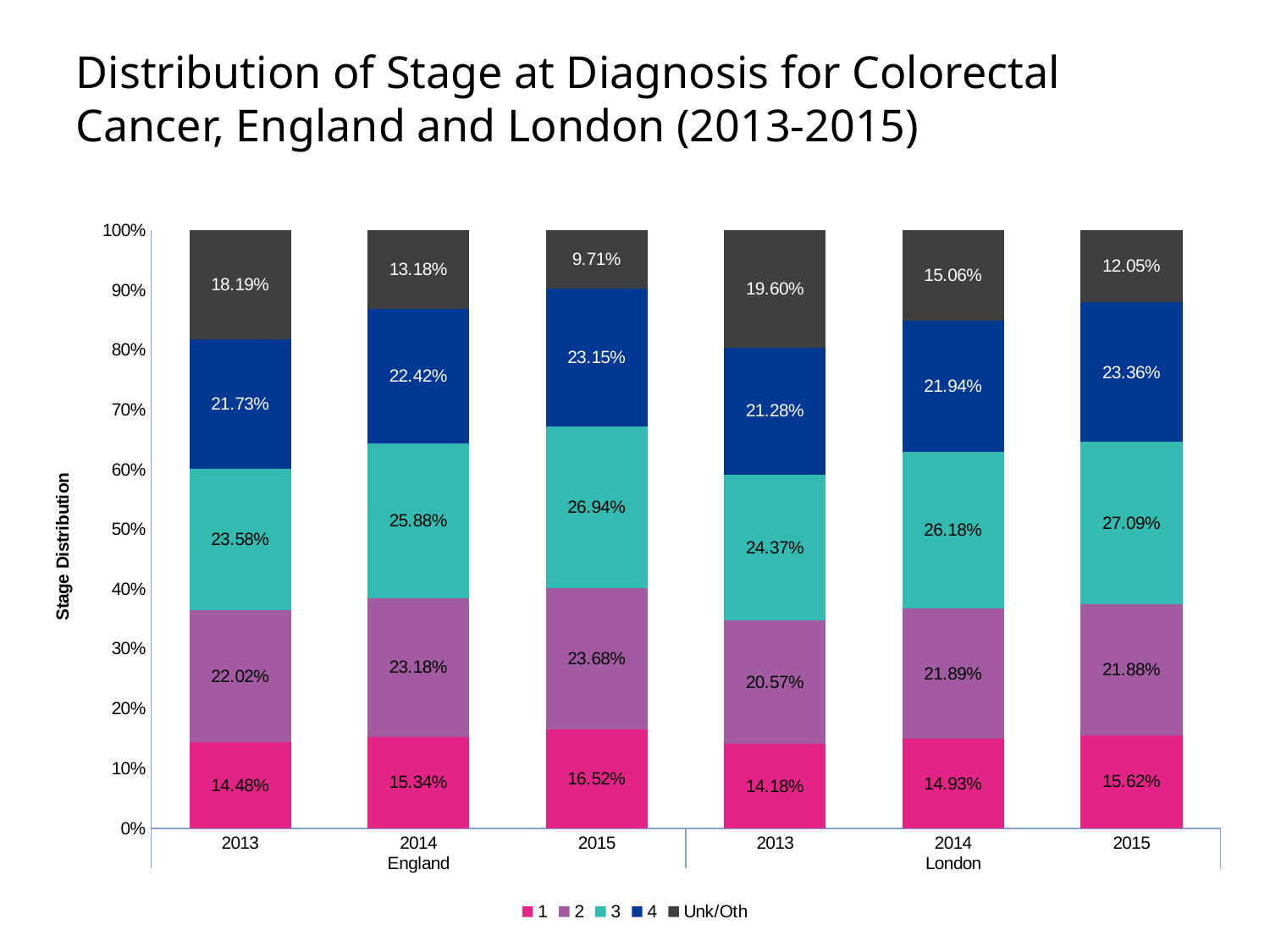
Which is larger, the stage 4 share for England in 2014 or for London in 2014? England 2014 (22.42%) What kind of chart is shown on the slide? Stacked bar chart What is the difference between the Unk/Oth share for London in 2013 and in 2015? 7.55 percentage points Which bar has the highest Unk/Oth share? London 2013 (19.60%) How many bars are shown in the chart? 6 What is the Unk/Oth share for London in 2015? 12.05% Which bar has the highest stage 1 share? England 2015 (16.52%) What percentage of colorectal cancer cases in England in 2013 were diagnosed at stage 1? 14.48% What is the stage 3 share for England in 2014? 25.88% By how many percentage points did the stage 3 share in England change from 2013 to 2015? 3.36 percentage points How many series does the legend list? 5 Which bar has the lowest Unk/Oth share? England 2015 (9.71%)